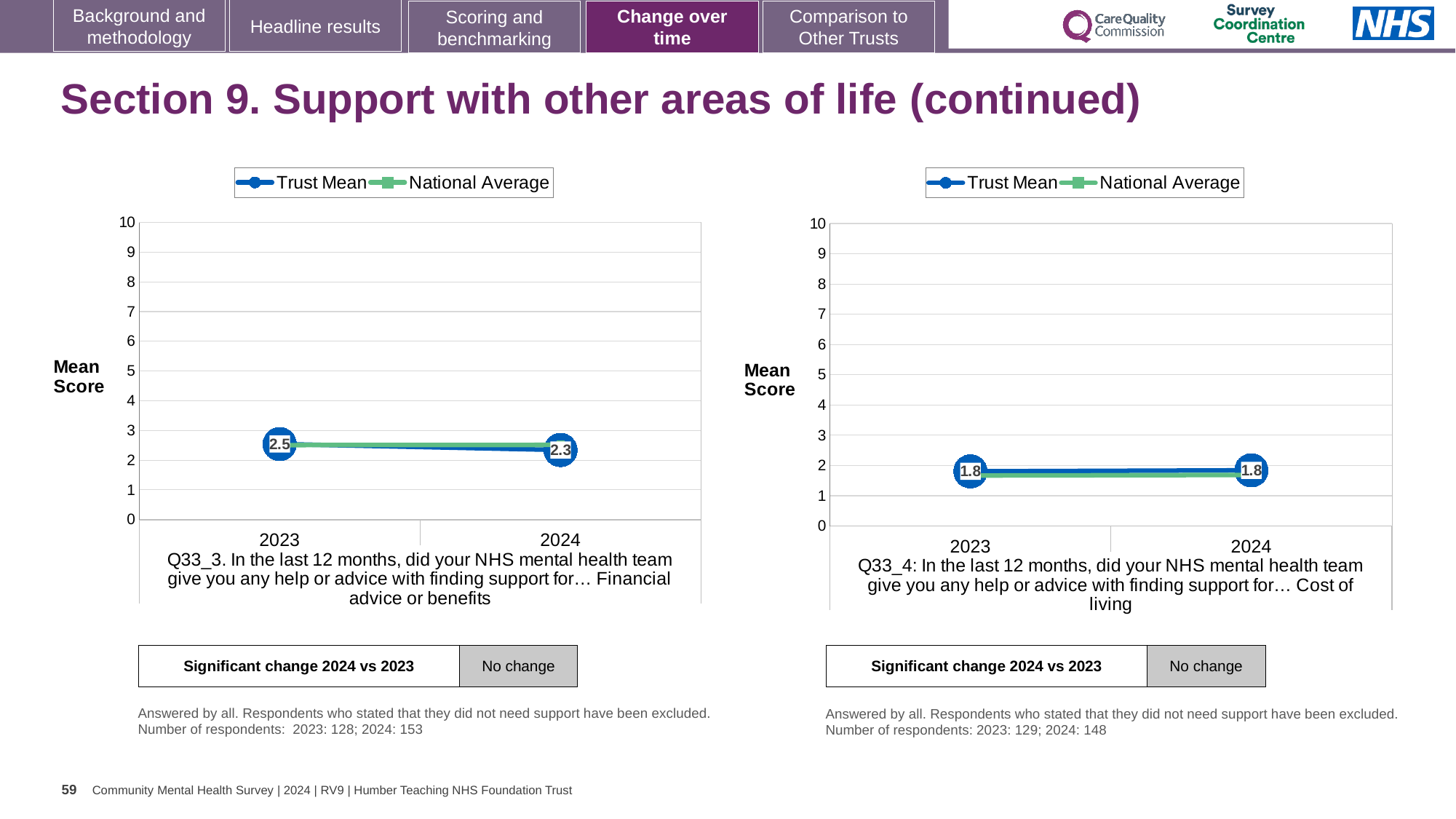
On the left chart (Q33_3), by how much did the Trust Mean score change from 2023 to 2024? 0.2 What kind of chart is the left chart (Q33_3)? line chart What are the two series named in the legend of the left chart (Q33_3)? Trust Mean and National Average How many years are plotted on the x axis of the left chart (Q33_3)? 2 How many series does the legend of the right chart (Q33_4) list? 2 On the left chart (Q33_3), does the Trust Mean rise or fall from 2023 to 2024? fall On the right chart (Q33_4, Cost of living), what is the Trust Mean score for 2024? 1.8 On the left chart (Q33_3, Financial advice or benefits), what is the Trust Mean score for 2023? 2.5 On the right chart (Q33_4), is the National Average value for 2024 greater or less than 5? less On the right chart (Q33_4), does the Trust Mean rise, fall or stay the same from 2023 to 2024? stay the same On the right chart (Q33_4, Cost of living), what is the Trust Mean score for 2023? 1.8 On the left chart (Q33_3, Financial advice or benefits), what is the Trust Mean score for 2024? 2.3